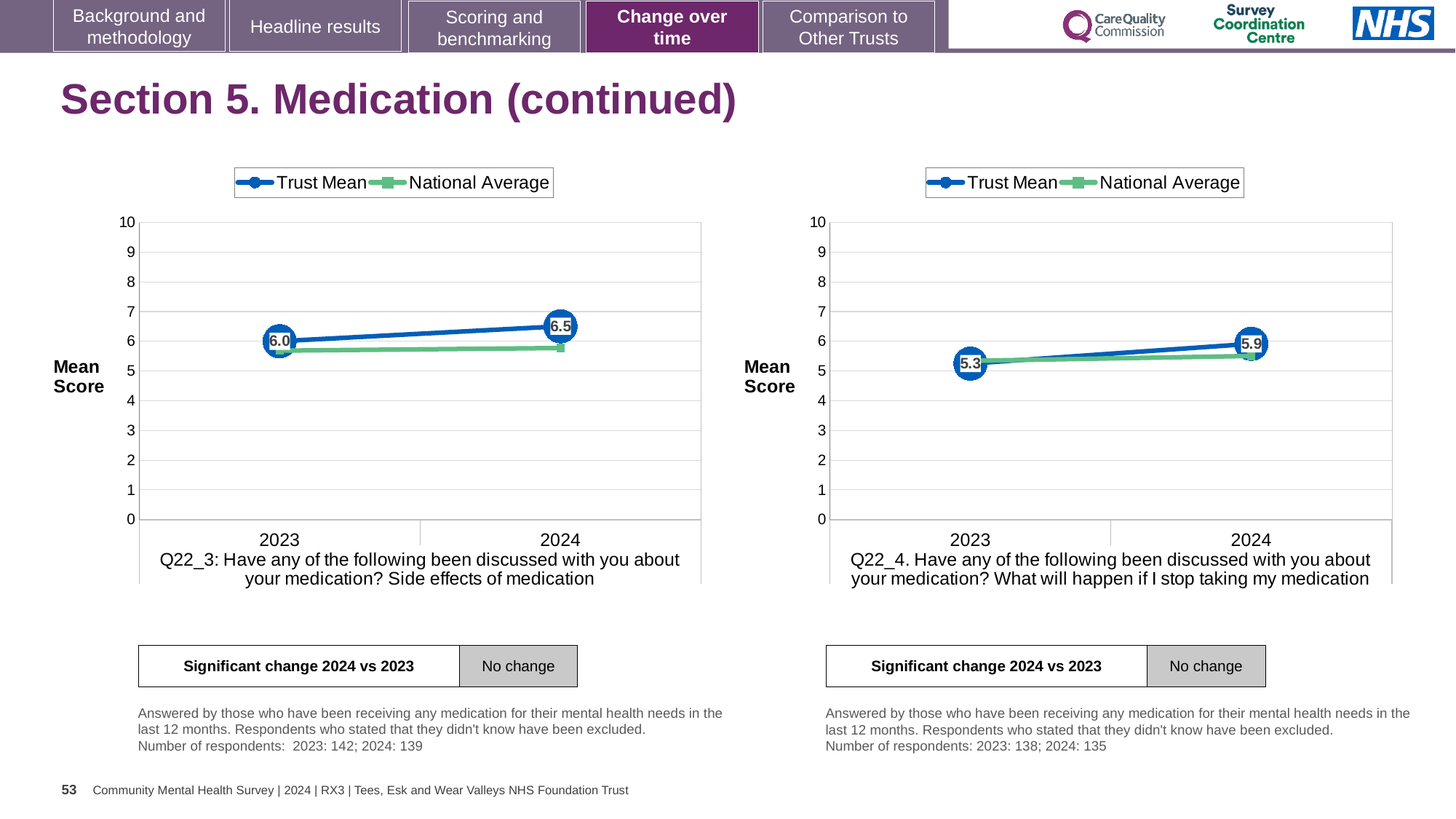
How many series does the legend of the right chart (Q22_4) list? 2 In the left chart (Q22_3), does the Trust Mean rise or fall from 2023 to 2024? rise In the left chart (Q22_3), what is the Trust Mean score for 2024? 6.5 In the left chart (Q22_3), is the National Average value for 2024 greater or less than 7? less In the left chart (Q22_3), what is the Trust Mean score for 2023? 6.0 In the left chart (Q22_3), by how much did the Trust Mean change from 2023 to 2024? 0.5 What kind of chart is the left chart (Q22_3)? line chart In the right chart (Q22_4), what is the Trust Mean score for 2023? 5.3 In the right chart (Q22_4), what is the Trust Mean score for 2024? 5.9 How many years are shown on the x axis of the left chart (Q22_3)? 2 In the right chart (Q22_4), what is the difference between the Trust Mean in 2024 and in 2023? 0.6 In the right chart (Q22_4), which year has the higher Trust Mean, 2023 or 2024? 2024